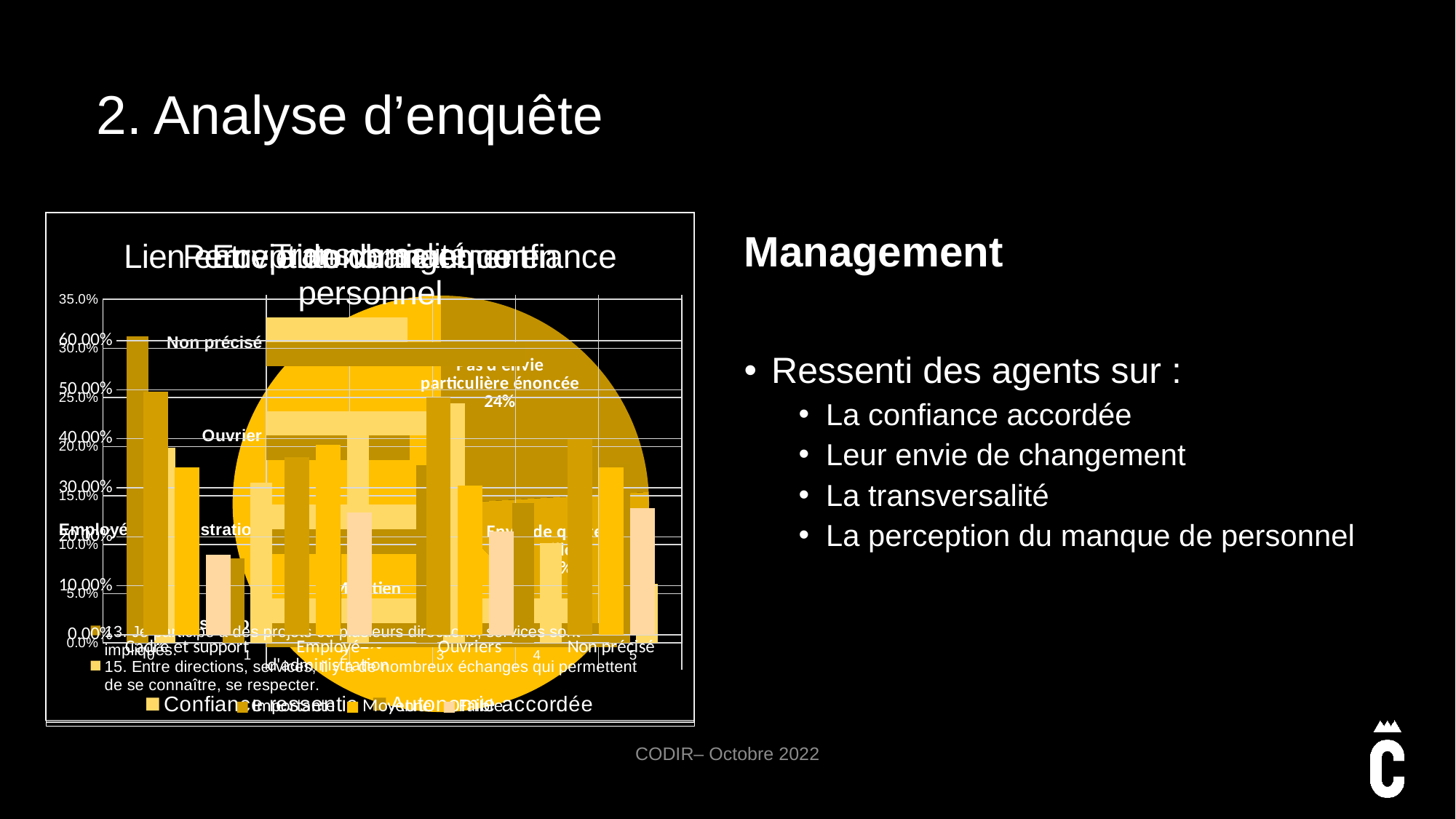
In the pie chart on the slide, what percentage is shown for the slice labelled 'Pas d'envie particulière énoncée'? 24% What is the highest tick value shown on the vertical axis that runs from 0.0% in steps of 5.0% on the left-hand chart? 35.0% What kind of chart is the large yellow circular chart overlapping the bar charts on the left of the slide? pie chart In the bar chart whose legend lists 'Confiance ressentie' and 'Autonomie accordée', how many series does the legend list? 2